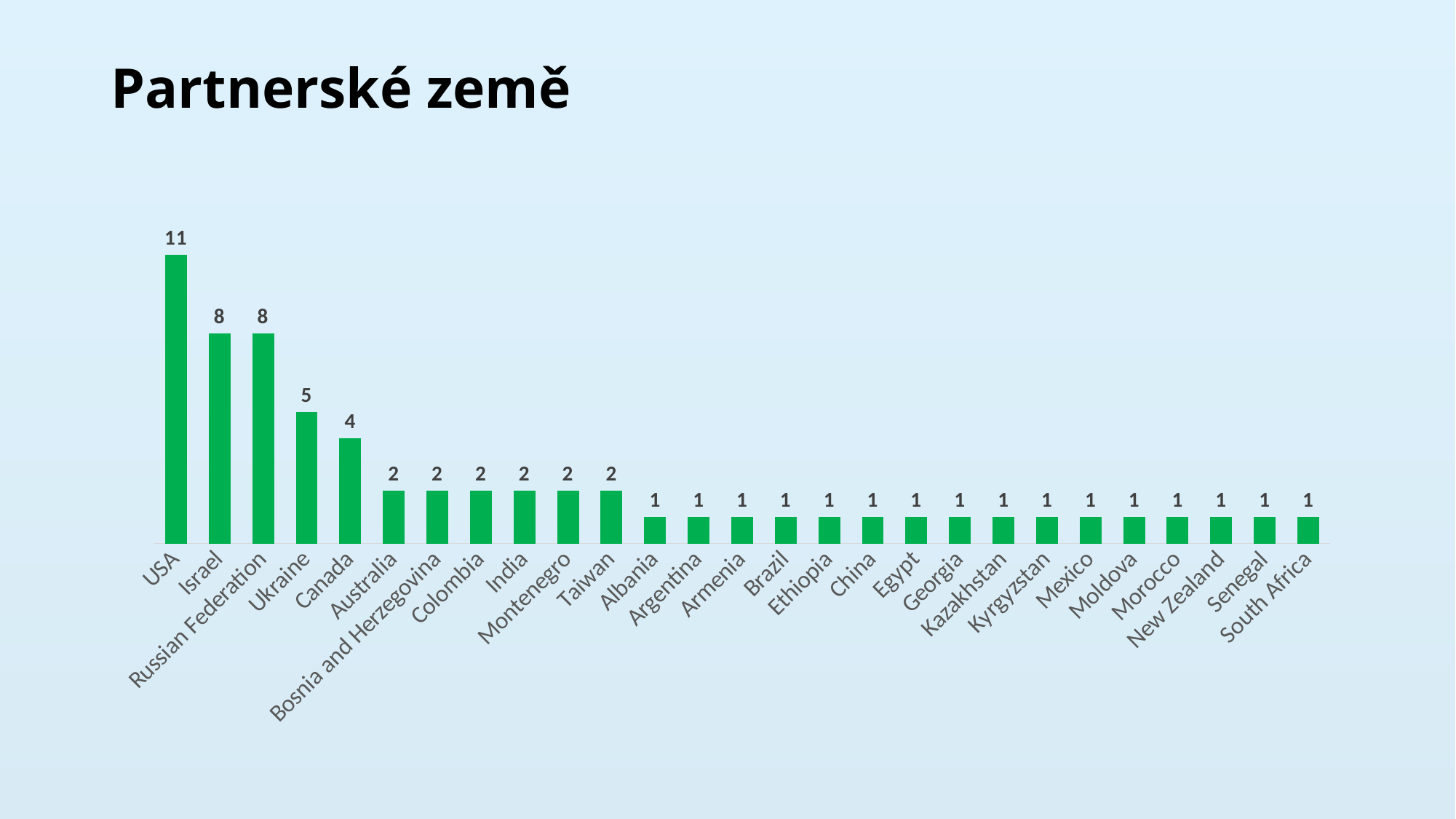
What is the difference between the values for USA and Israel? 3 Which is larger, the value for Canada or the value for Australia? Canada What is the value for Ukraine? 5 What kind of chart is shown on the slide? bar chart How many countries have a value of 1? 16 What is the value for USA? 11 What is the value for Montenegro? 2 How many countries are shown on the chart? 27 Which country has the highest value? USA What is the title of the slide? Partnerské země What is the difference between the values for Ukraine and Taiwan? 3 What is the value for Canada? 4